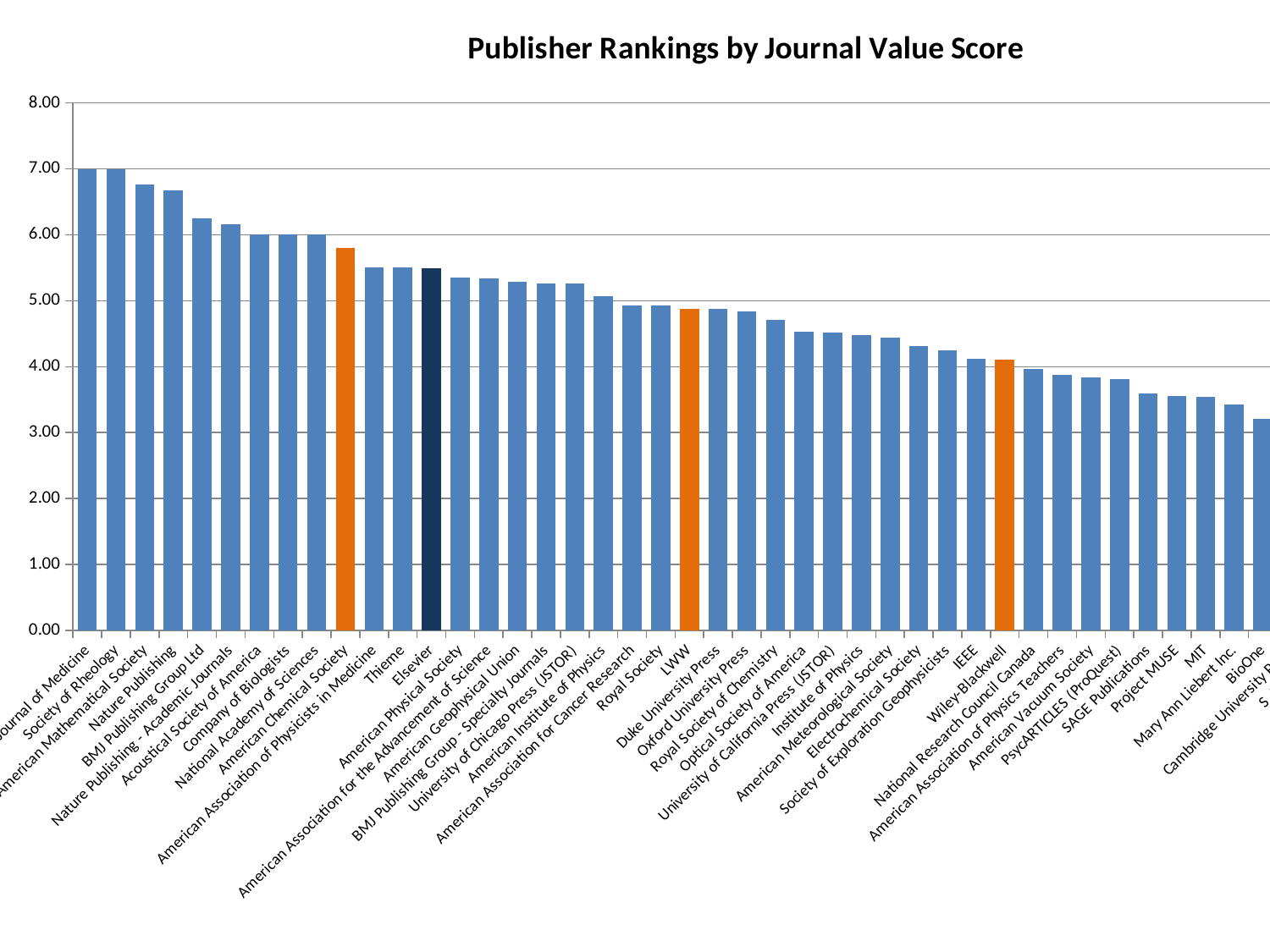
Is the value for Wiley-Blackwell greater or less than 5.00? less Is the value for MIT greater or less than 4.00? less Do the values generally rise or fall moving from left to right along the x axis? fall Is the value for Thieme greater or less than 6.00? less What is the title of the chart? Publisher Rankings by Journal Value Score What kind of chart is shown on the slide? bar chart Which publisher's bar is coloured dark navy rather than light blue or orange? Elsevier Which has the larger value, Nature Publishing or Thieme? Nature Publishing Which has the larger value, Elsevier or Wiley-Blackwell? Elsevier